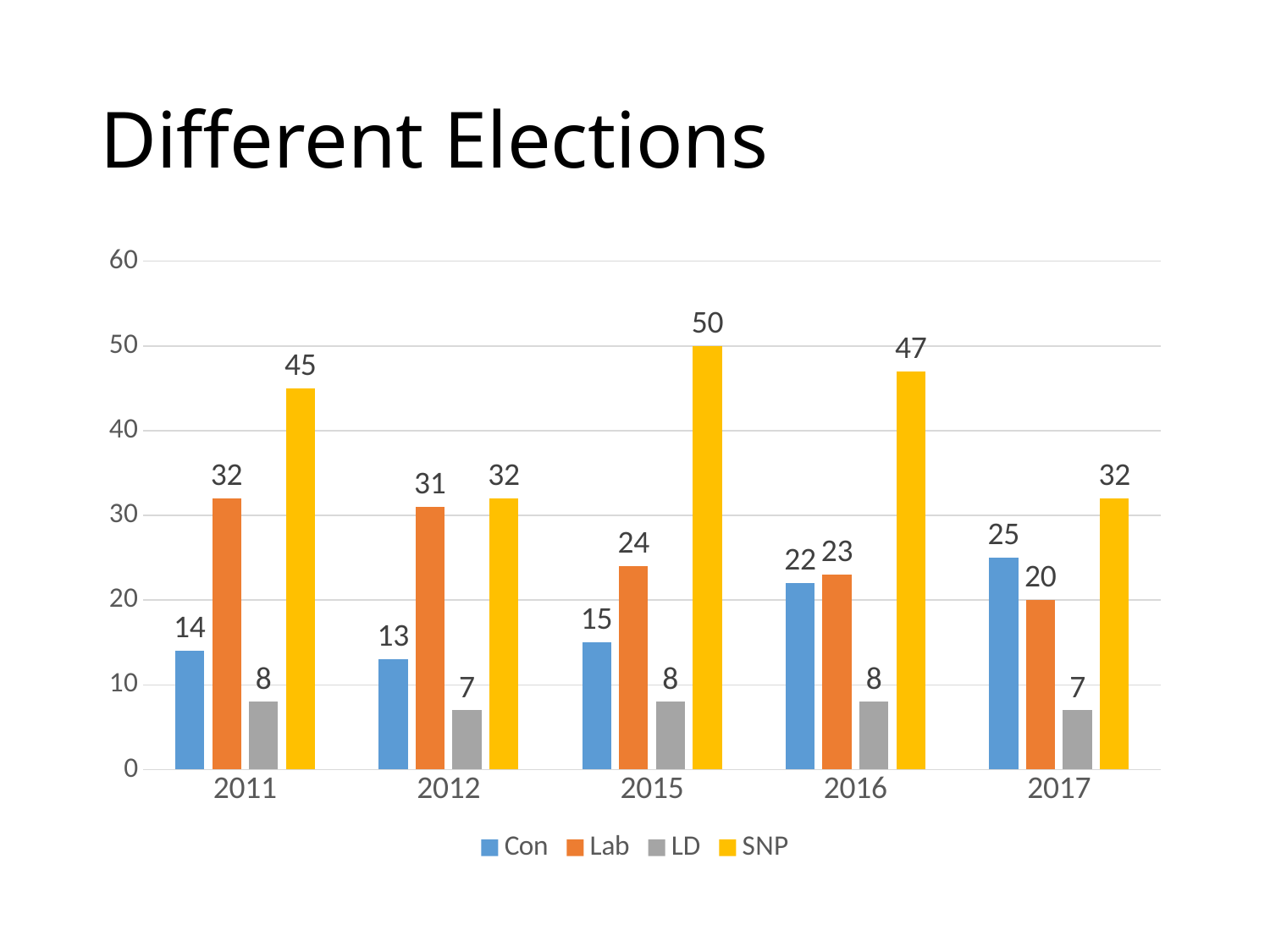
What is the value for SNP in 2015? 50 What kind of chart is shown on the slide? Bar chart In which year is the Con value lowest? 2012 In which year is the SNP value highest? 2015 How many series does the legend list? 4 Which is larger in 2017, Con or Lab? Con What is the title of the slide? Different Elections What is the difference between the SNP and Lab values in 2011? 13 What is the value for LD in 2012? 7 How many years are shown on the x axis? 5 What is the value for Con in 2017? 25 Is the value for SNP in 2016 greater or less than 40? greater